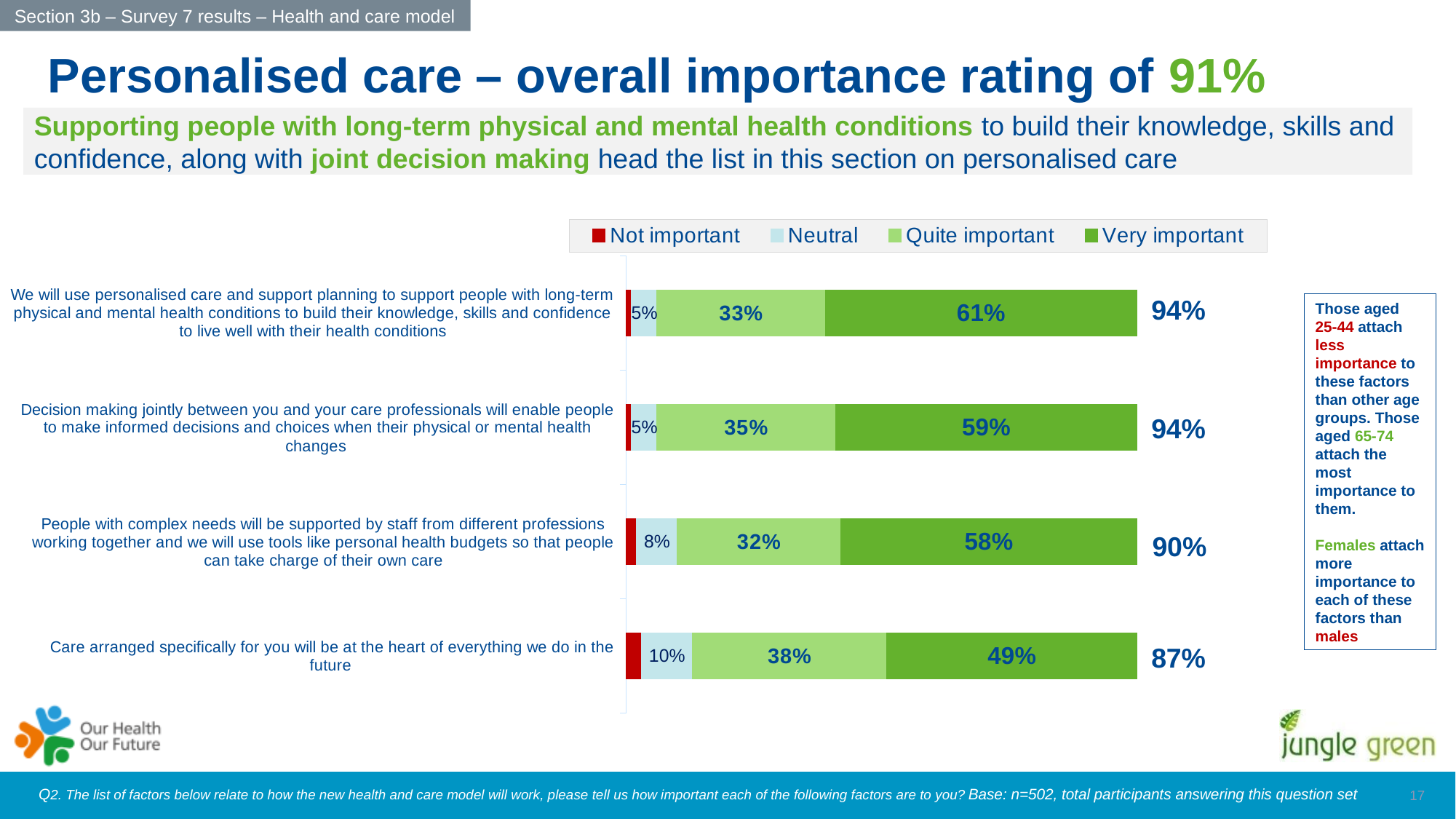
What is the 'Neutral' value for the statement about people with complex needs being supported by staff from different professions? 8% How many statements (categories) are plotted in the chart? 4 What is the overall importance figure shown at the end of the bar for the statement about decision making jointly between you and your care professionals? 94% What is the 'Quite important' value for the statement 'Care arranged specifically for you will be at the heart of everything we do in the future'? 38% What is the 'Very important' value for the statement about using personalised care and support planning to support people with long-term physical and mental health conditions? 61% Which statement has the lowest 'Very important' value? Care arranged specifically for you will be at the heart of everything we do in the future Which statement has the highest 'Neutral' value? Care arranged specifically for you will be at the heart of everything we do in the future How many series does the legend list? 4 What is the combined 'Quite important' and 'Very important' total for the statement about people with complex needs? 90% Is the 'Quite important' value larger for the joint decision making statement or for the complex needs statement? Joint decision making statement What is the difference between the 'Very important' values for the personalised care and support planning statement and the 'Care arranged specifically for you' statement? 12% What kind of chart is shown on the slide? Stacked bar chart